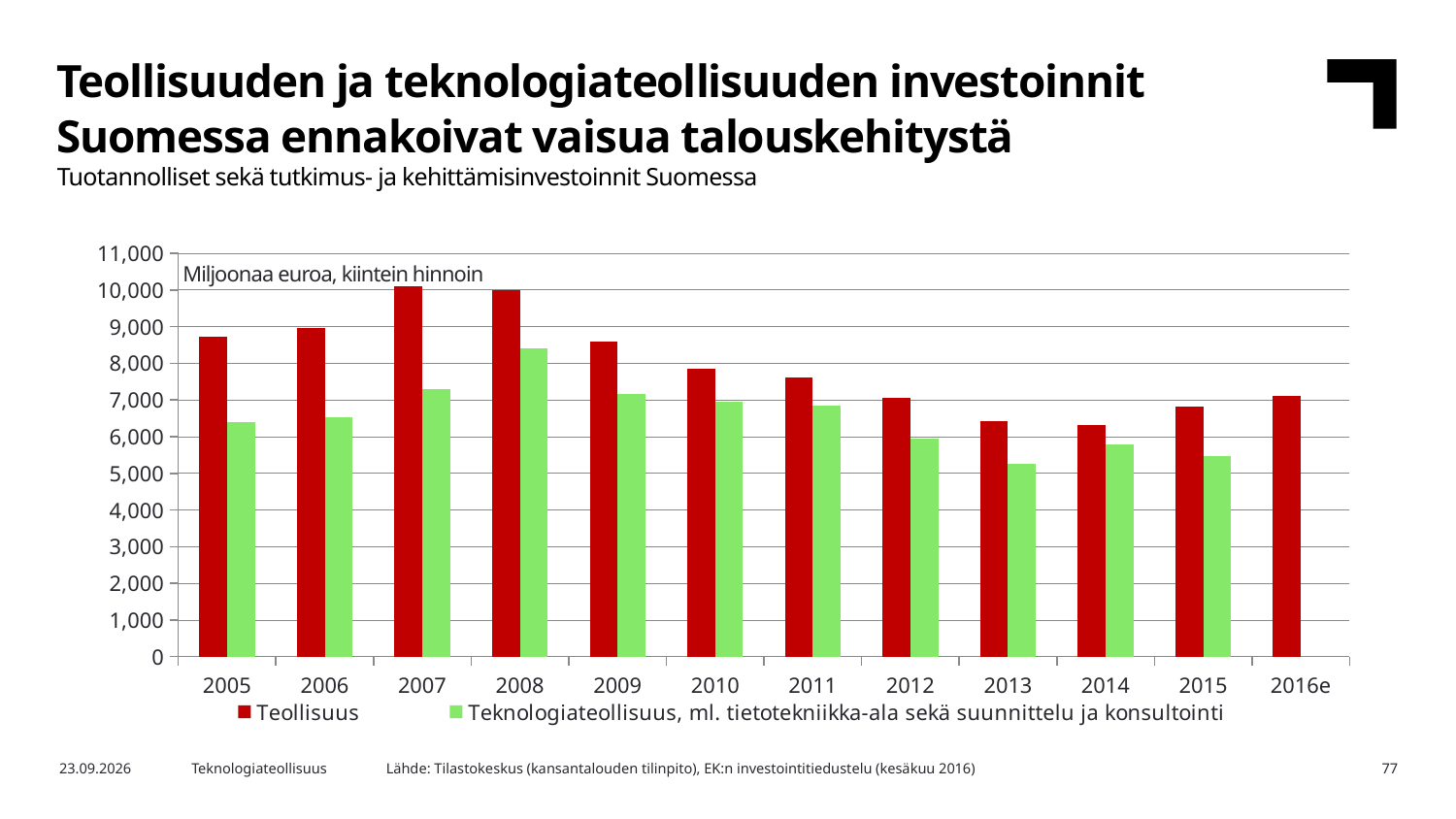
Is the Teollisuus value for 2005 greater or less than 8,000? greater How many series does the legend list? 2 Do the Teknologiateollisuus values rise or fall from 2008 to 2013? fall What unit is stated in the label inside the chart area? Miljoonaa euroa, kiintein hinnoin Is the Teknologiateollisuus value for 2008 greater or less than 8,000? greater What kind of chart is shown on the slide? bar chart In which year is the Teknologiateollisuus value lowest? 2013 Is the Teollisuus value for 2013 greater or less than 6,000? greater In which year is the Teknologiateollisuus value highest? 2008 How many years are shown on the x axis? 12 Which is larger in 2010, the Teollisuus value or the Teknologiateollisuus value? Teollisuus